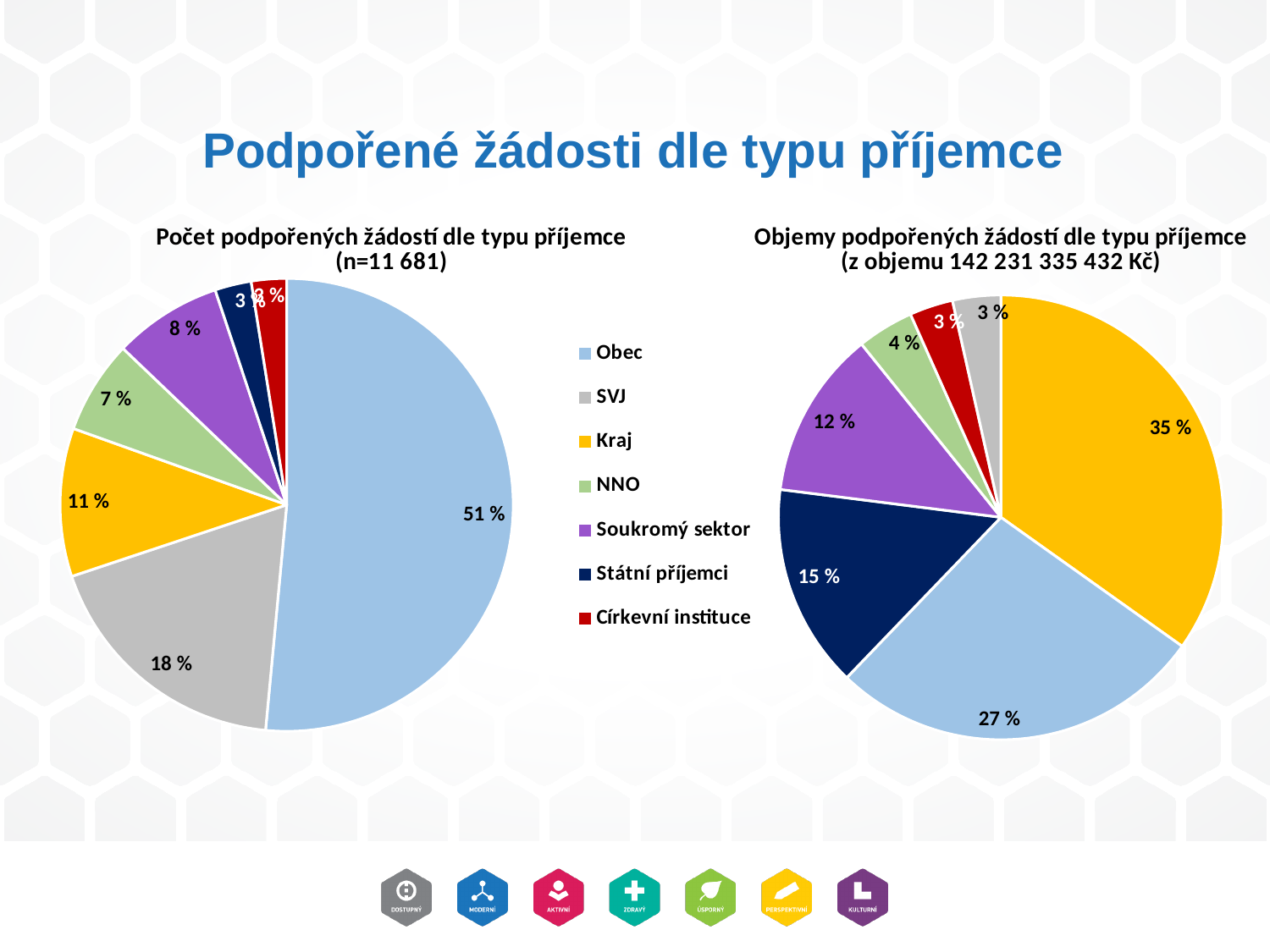
In the right chart (Objemy podpořených žádostí dle typu příjemce), which recipient type has the largest share? Kraj How many recipient types does the legend list? 7 In the left chart (Počet podpořených žádostí dle typu příjemce), which recipient type has the largest share? Obec In the right chart (Objemy podpořených žádostí dle typu příjemce), what is the difference between the Kraj share and the Obec share? 8 % In the left chart (Počet podpořených žádostí dle typu příjemce), what share is SVJ? 18 % In the right chart (Objemy podpořených žádostí dle typu příjemce), what share is Kraj? 35 % In the left chart (Počet podpořených žádostí dle typu příjemce), what share is Kraj? 11 % In the left chart (Počet podpořených žádostí dle typu příjemce), which is larger, the share for Soukromý sektor or the share for NNO? Soukromý sektor In the left chart (Počet podpořených žádostí dle typu příjemce), what share of supported applications is for Obec? 51 % In the right chart (Objemy podpořených žádostí dle typu příjemce), what share is Soukromý sektor? 12 % In the right chart (Objemy podpořených žádostí dle typu příjemce), what share is Státní příjemci? 15 % What type of chart is used on this slide? Pie chart